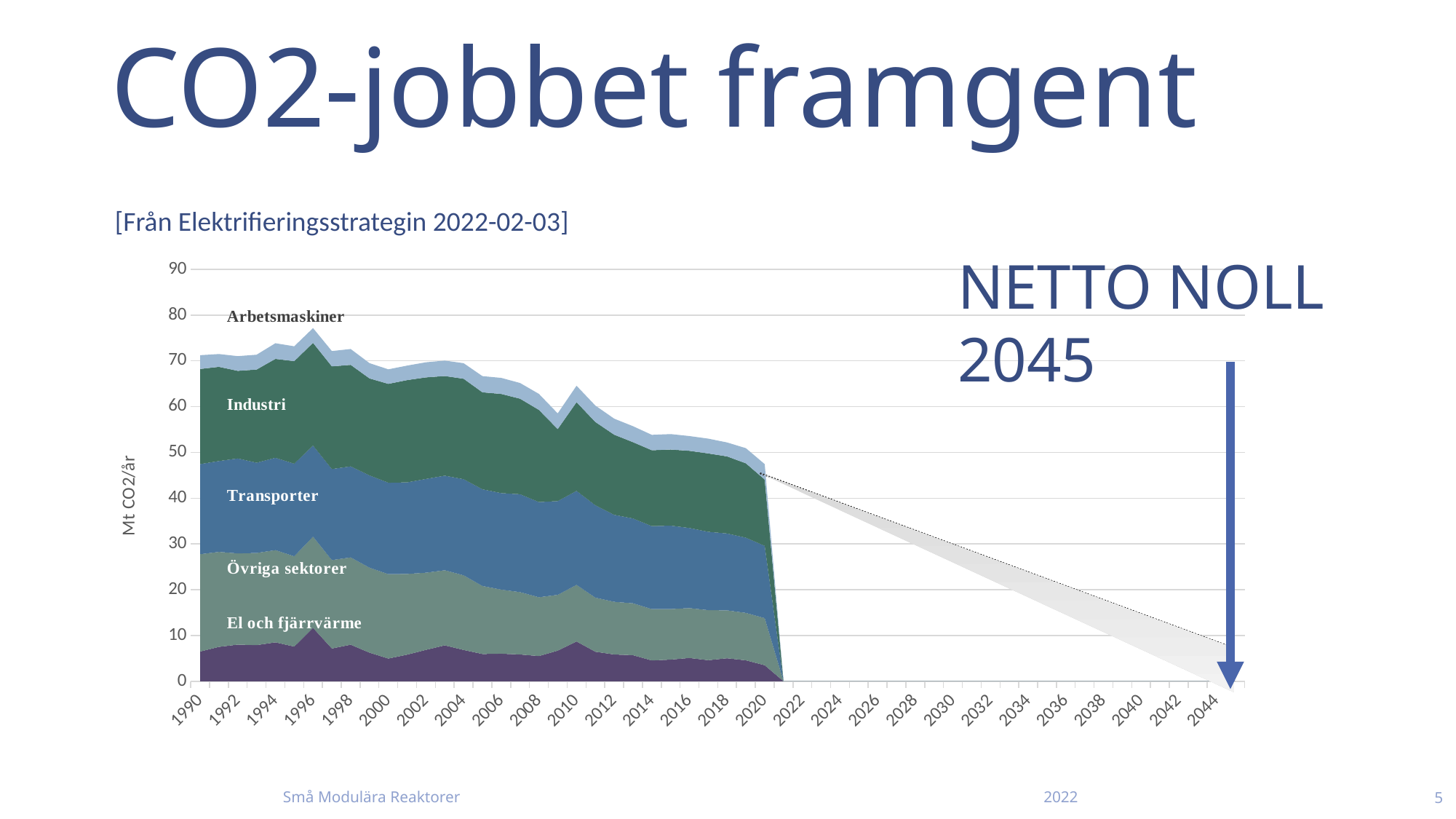
In which year does the chart indicate net zero (NETTO NOLL) is reached? 2045 Is the total value in 2020 greater or less than 50? less What is the highest tick value shown on the vertical axis? 90 Do total emissions rise or fall from 1990 to 2020 in the chart? Fall Is the value for El och fjärrvärme in 2020 greater or less than 10? less What is the label on the vertical axis of the chart? Mt CO2/år What kind of chart is shown on the slide? Stacked area chart Which sector forms the thinnest (smallest) layer in the chart? Arbetsmaskiner Which sector forms the bottom layer of the stacked area chart? El och fjärrvärme How many sectors (series) are labelled in the chart? 5 Is the total value in 2010 greater or less than 60? greater